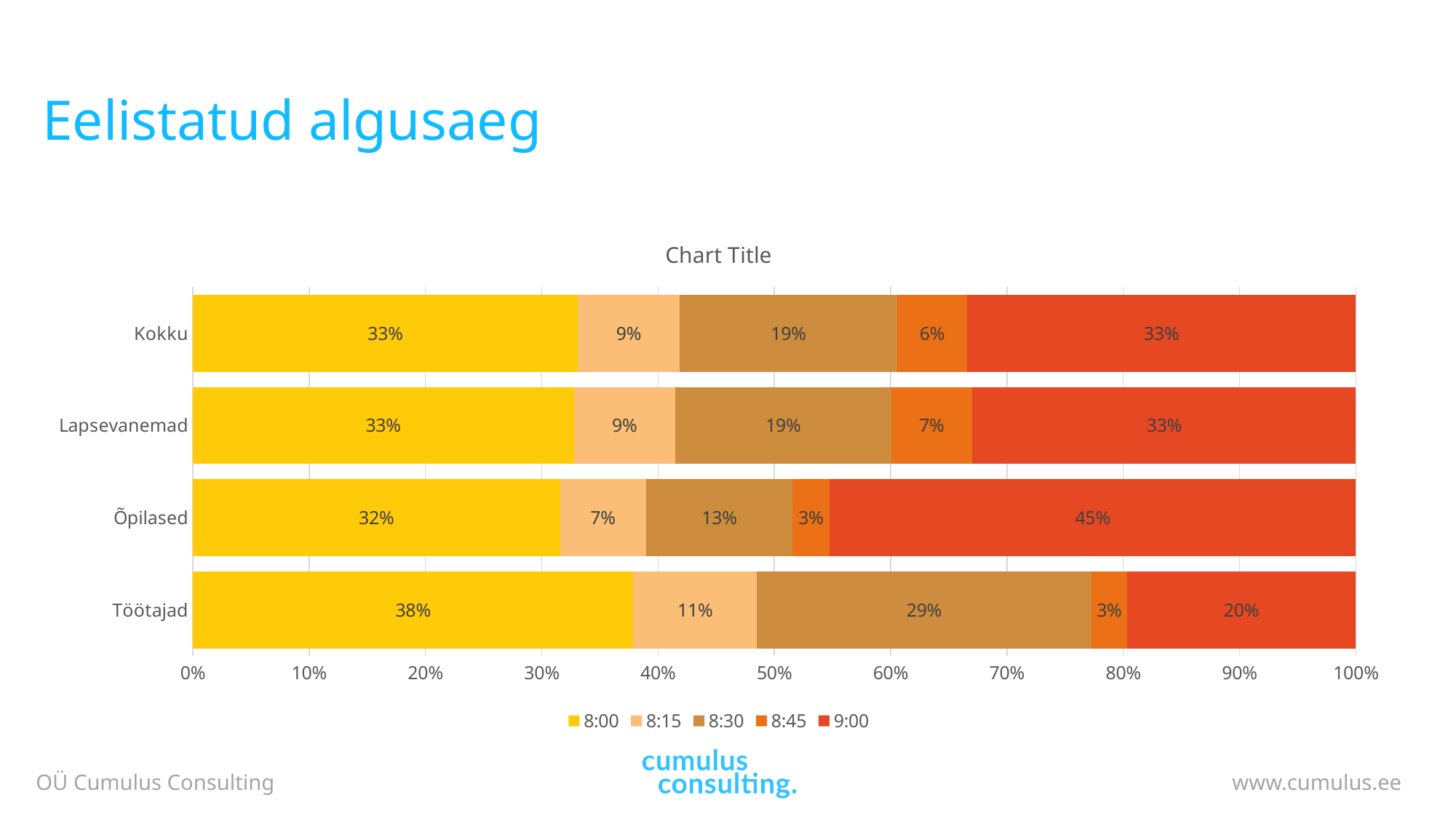
What is the value for 8:45 in the Lapsevanemad bar? 7% Which category has the highest value for 9:00? Õpilased What is the value for 8:30 in the Töötajad bar? 29% How many categories are shown on the chart? 4 What is the value for 8:15 in the Kokku bar? 9% How many series does the legend list? 5 Which category has the highest value for 8:00? Töötajad Which is larger: the 8:30 value for Töötajad or the 8:30 value for Õpilased? Töötajad Which category has the lowest value for 9:00? Töötajad What kind of chart is shown on the slide? Stacked bar chart What is the value for 9:00 in the Õpilased bar? 45% What is the difference between the 9:00 values for Õpilased and Töötajad? 25%